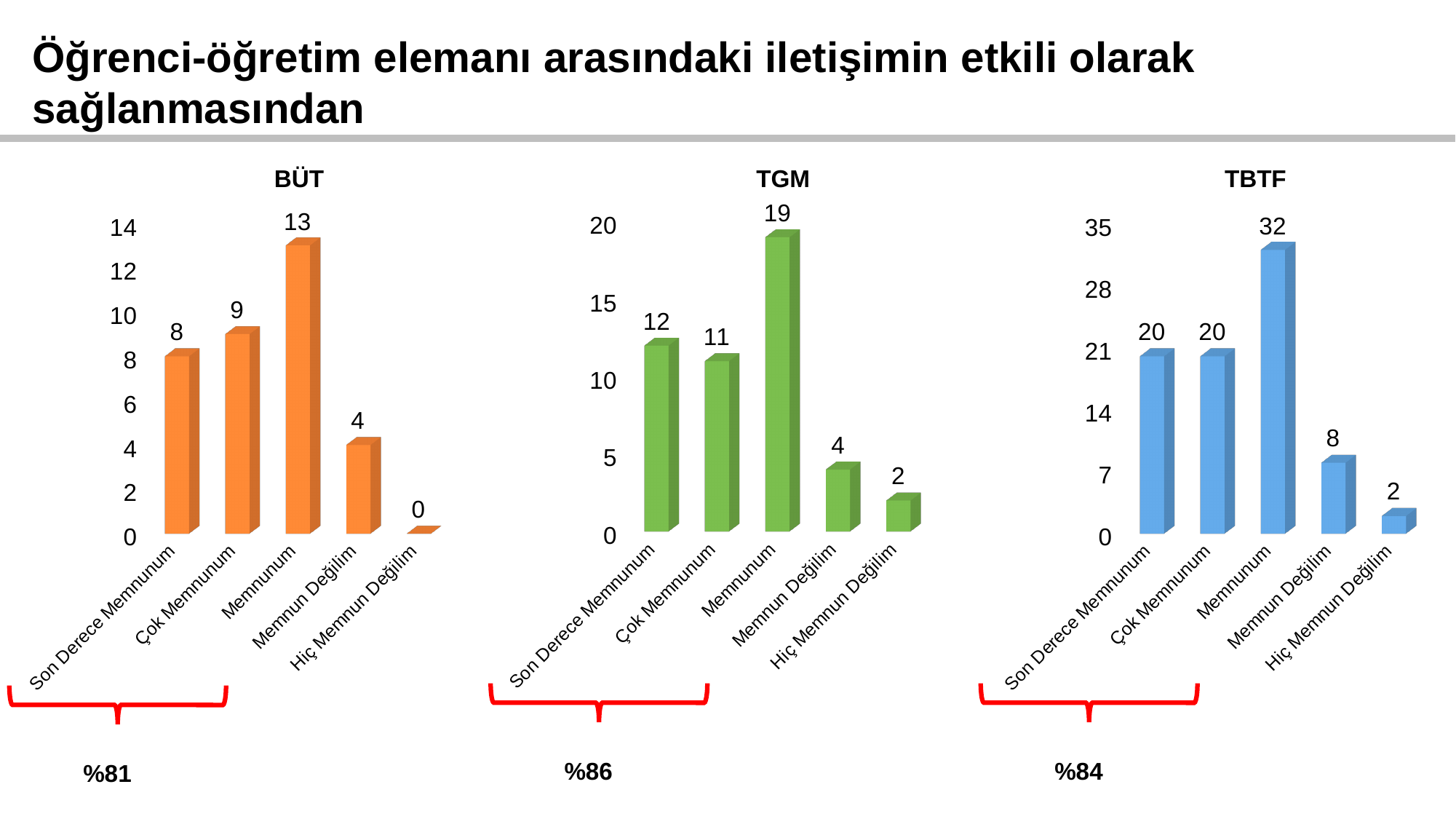
In the TBTF chart, what is the difference between Memnunum and Son Derece Memnunum? 12 In the TGM chart, what is the difference between Memnunum and Çok Memnunum? 8 What colour are the bars in the BÜT chart? orange In the TGM chart, is the value for Memnunum greater or less than 15? greater In the BÜT chart, which category has the lowest value? Hiç Memnun Değilim In the TGM chart, what is the value for Son Derece Memnunum? 12 In the TBTF chart, what is the value for Memnun Değilim? 8 How many categories does the TBTF chart show? 5 In the TBTF chart, which category has the highest value? Memnunum What kind of chart is the TGM chart? bar chart In the BÜT chart, what is the value for Memnunum? 13 In the BÜT chart, which is larger: Çok Memnunum or Memnun Değilim? Çok Memnunum